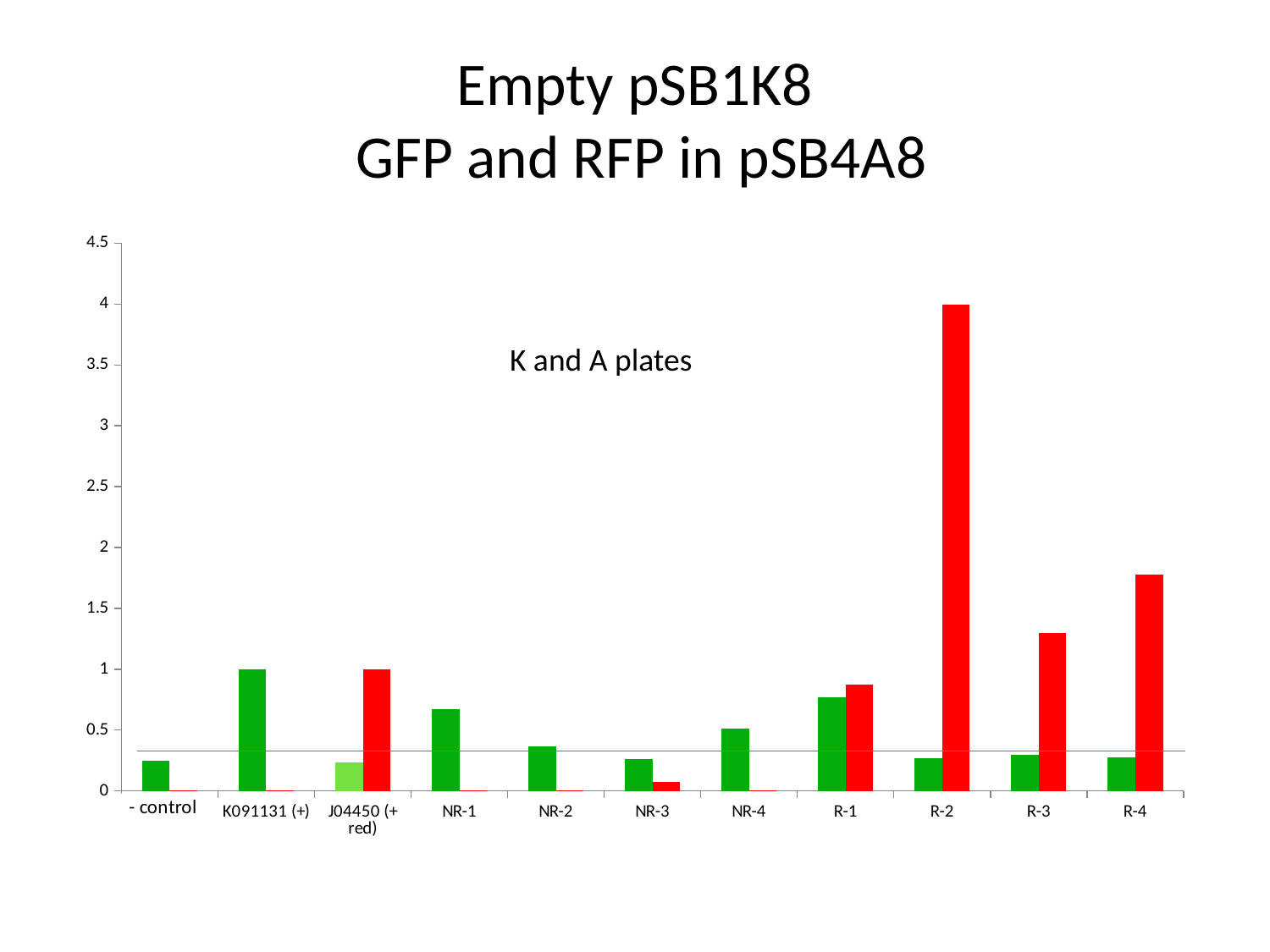
How many categories are shown along the x axis of the chart? 11 Is the value of the red bar for R-4 greater or less than 1.5? greater Is the value of the red bar for R-2 greater or less than 3? greater What is the value of the red bar for J04450 (+ red)? 1 Which category has the tallest red bar? R-2 Is the value of the green bar for NR-1 greater or less than 0.5? greater Which has the larger green bar, NR-1 or NR-2? NR-1 What text label appears inside the plot area of the chart? K and A plates What kind of chart is shown on the slide? bar chart What is the value of the green bar for K091131 (+)? 1 Which has the larger red bar, R-3 or R-4? R-4